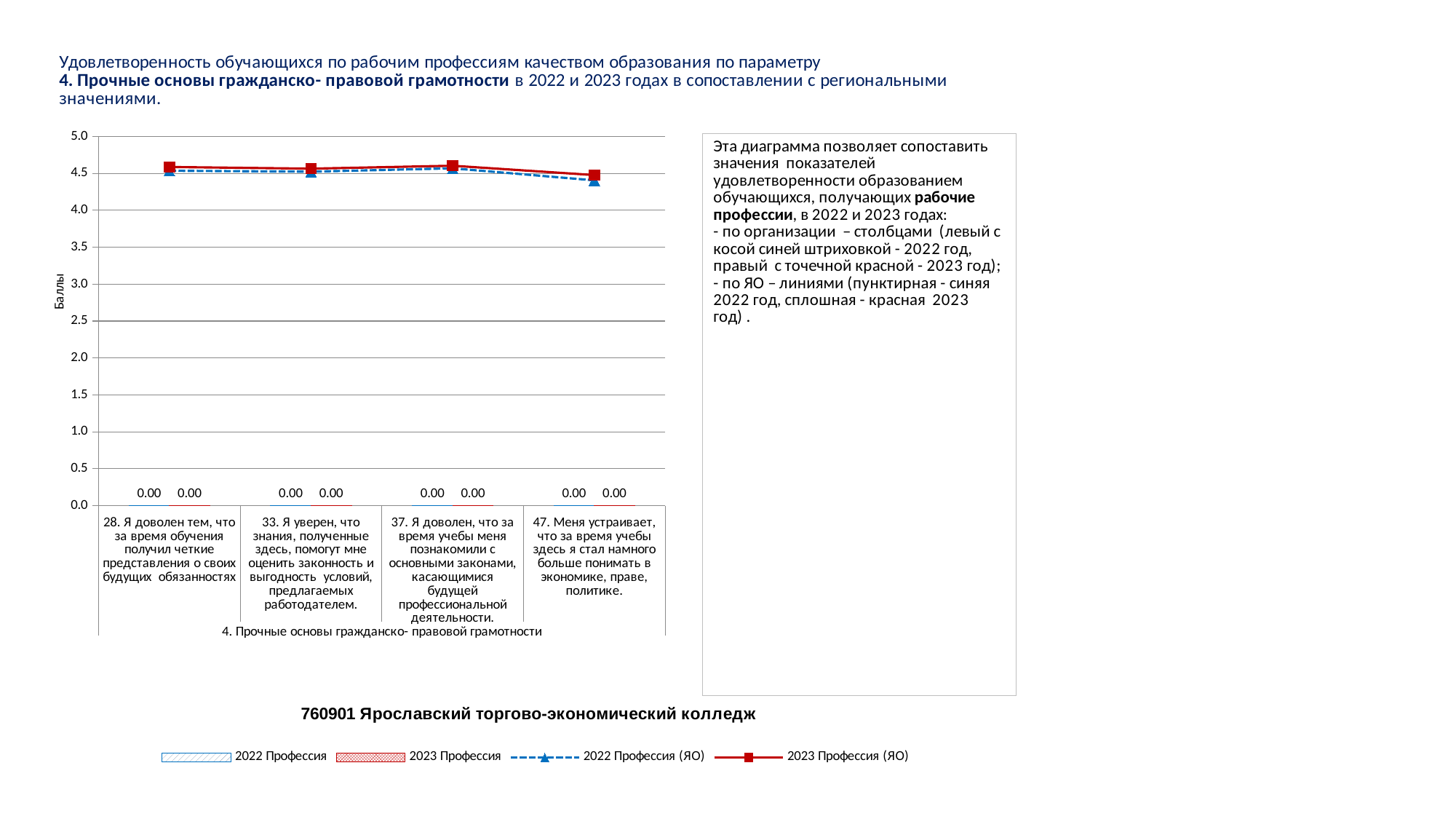
What is the title of the chart? 760901 Ярославский торгово-экономический колледж How many question categories are shown on the x axis of the chart? 4 For which question category is the 2023 Профессия (ЯО) line at its lowest value? 47. Меня устраивает, что за время учебы здесь я стал намного больше понимать в экономике, праве, политике. Is the value of the 2022 Профессия (ЯО) line for question 47 greater or less than 4.5? less Is the value of the 2023 Профессия (ЯО) line for question 47 greater or less than 4.0? greater What is the value of the 2022 Профессия bar for question 28 ("Я доволен тем, что за время обучения получил четкие представления о своих будущих обязанностях")? 0.00 What is the value of the 2023 Профессия bar for question 47 ("Меня устраивает, что за время учебы здесь я стал намного больше понимать в экономике, праве, политике")? 0.00 How many series does the chart legend list? 4 For question 47, which line is higher: 2022 Профессия (ЯО) or 2023 Профессия (ЯО)? 2023 Профессия (ЯО) What is the label of the vertical axis of the chart? Баллы Is the value of the 2023 Профессия (ЯО) line for question 28 greater or less than 4.0? greater What kind of chart is shown on the slide? Combined bar and line chart